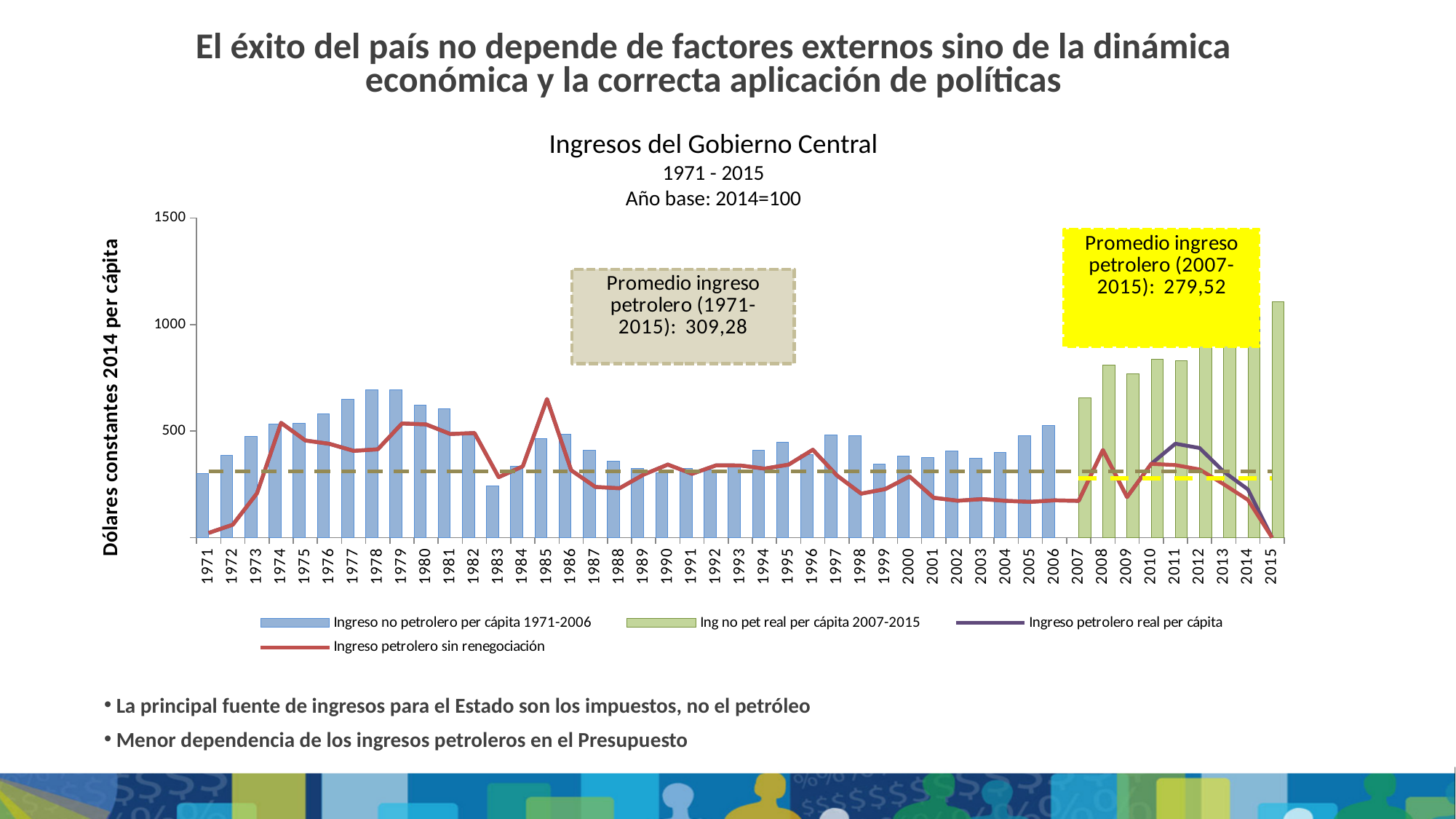
Do the green bars (Ing no pet real per cápita 2007-2015) generally rise or fall from 2007 to 2015? rise Is the bar value for 1983 greater or less than 500? less What is the title of the chart? Ingresos del Gobierno Central Which year has the highest bar in the chart? 2015 How many years are plotted along the x axis of the chart? 45 How many series does the chart legend list? 4 Is the bar value for 2015 greater or less than 1000? greater What is the difference between the 1971-2015 average oil income and the 2007-2015 average oil income shown on the chart? 29,76 What is the average oil income (Promedio ingreso petrolero) for 2007-2015 shown on the chart? 279,52 Which bar is larger, 1978 or 1983? 1978 What kind of chart is shown on the slide? Bar chart combined with line series What is the average oil income (Promedio ingreso petrolero) for 1971-2015 shown on the chart? 309,28